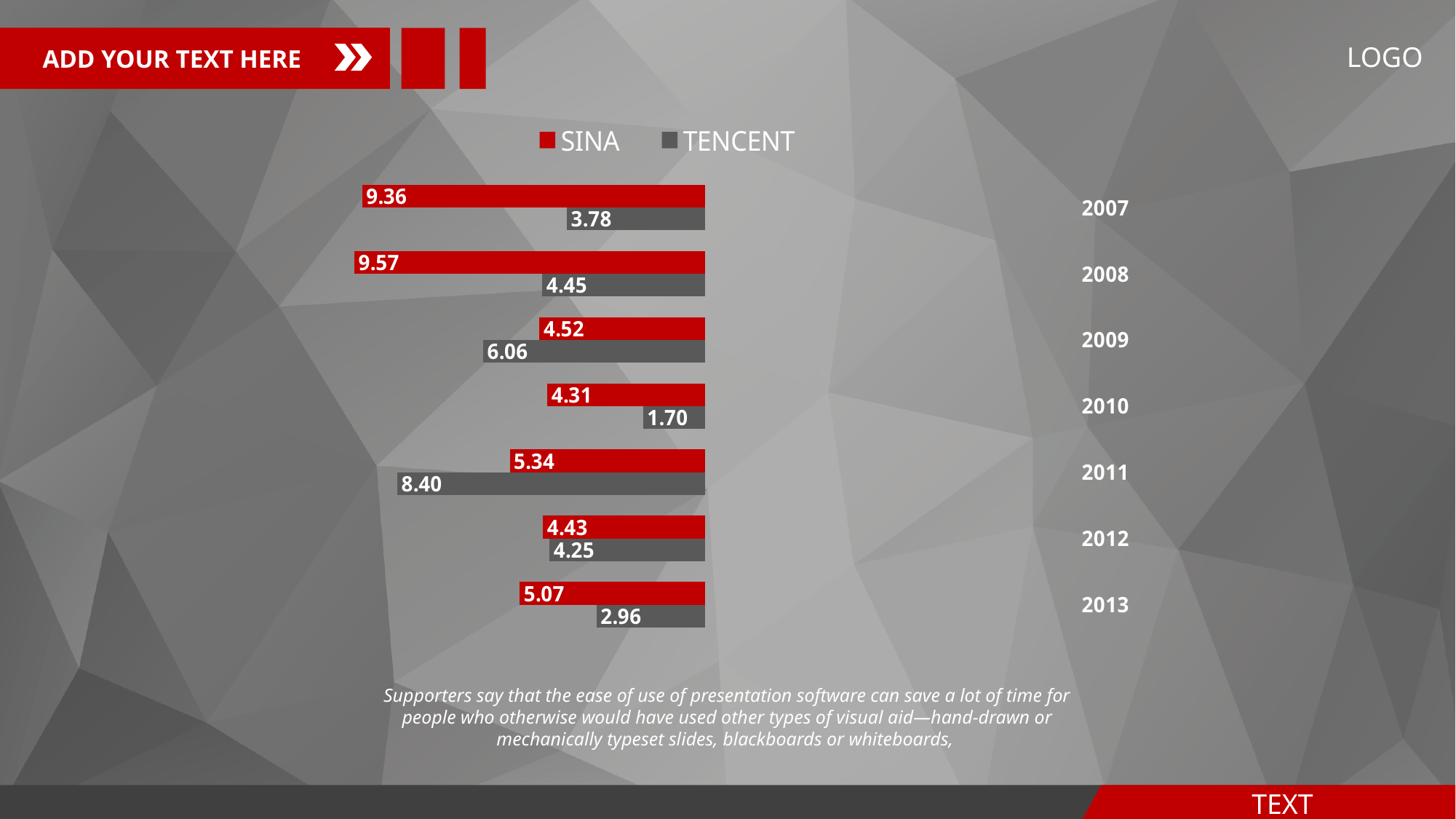
What is the SINA value for 2007? 9.36 What kind of chart is shown on the slide? Bar chart How many series does the legend list? 2 Which is larger in 2009, the SINA value or the TENCENT value? TENCENT What is the difference between the TENCENT values for 2011 and 2013? 5.44 How many years are shown on the chart? 7 Which year has the lowest TENCENT value? 2010 Which year has the highest SINA value? 2008 What is the difference between the SINA and TENCENT values in 2007? 5.58 What is the TENCENT value for 2011? 8.40 What is the TENCENT value for 2010? 1.70 Which colour represents SINA in the legend? Red